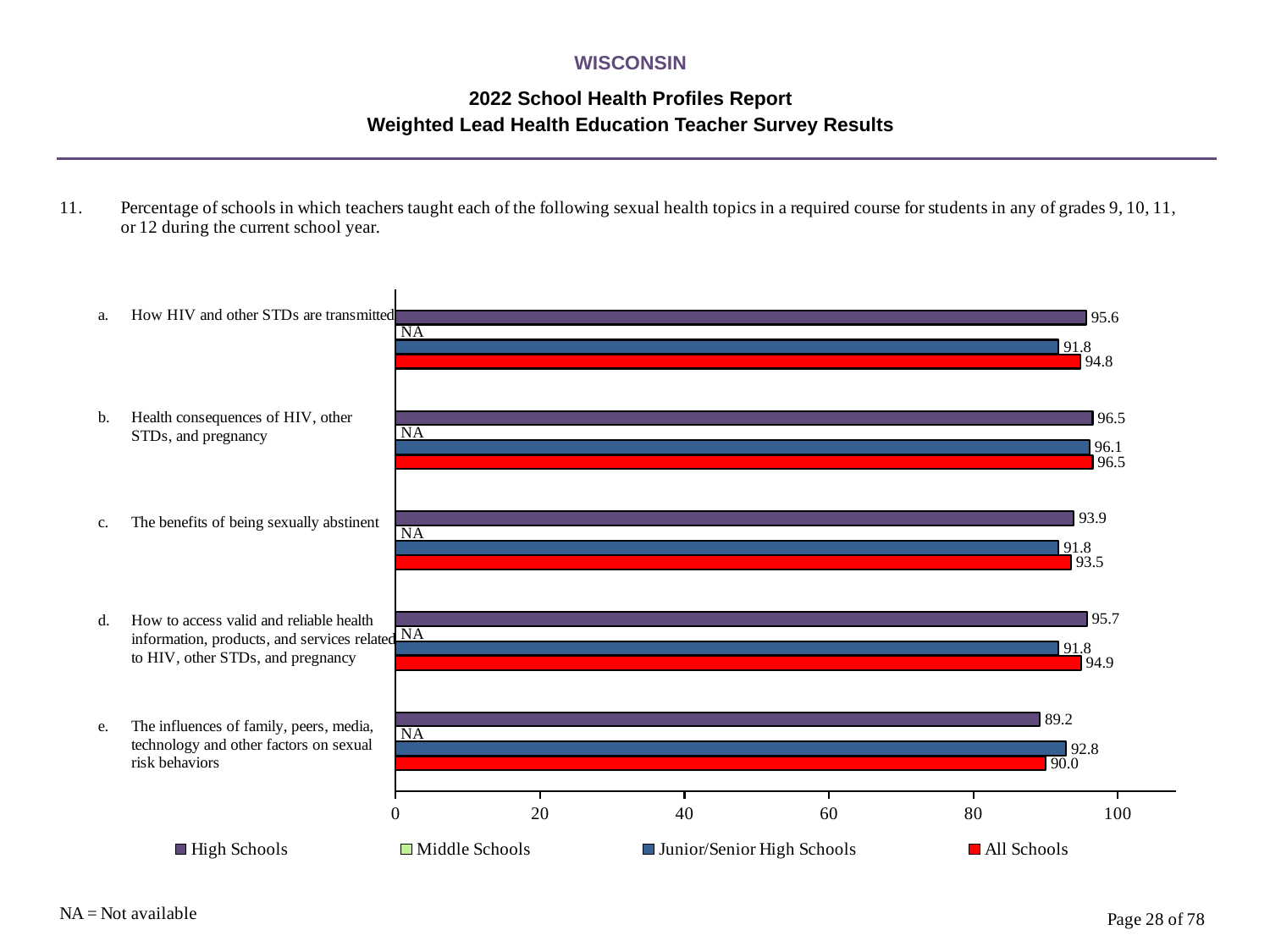
What is the All Schools value for 'The influences of family, peers, media, technology and other factors on sexual risk behaviors'? 90.0 What is the difference between the High Schools and Junior/Senior High Schools values for 'How to access valid and reliable health information, products, and services related to HIV, other STDs, and pregnancy'? 3.9 What is the High Schools value for 'How HIV and other STDs are transmitted'? 95.6 Which topic has the highest All Schools value? Health consequences of HIV, other STDs, and pregnancy Which series is shown in red in the legend? All Schools How many sexual health topics are listed on the chart? 5 How many series does the legend list? 4 Which topic has the lowest High Schools value? The influences of family, peers, media, technology and other factors on sexual risk behaviors What kind of chart is shown on the slide? Bar chart For 'The influences of family, peers, media, technology and other factors on sexual risk behaviors', which is larger: the High Schools value or the Junior/Senior High Schools value? Junior/Senior High Schools What is the Junior/Senior High Schools value for 'Health consequences of HIV, other STDs, and pregnancy'? 96.1 What is the Middle Schools value for 'The benefits of being sexually abstinent'? NA